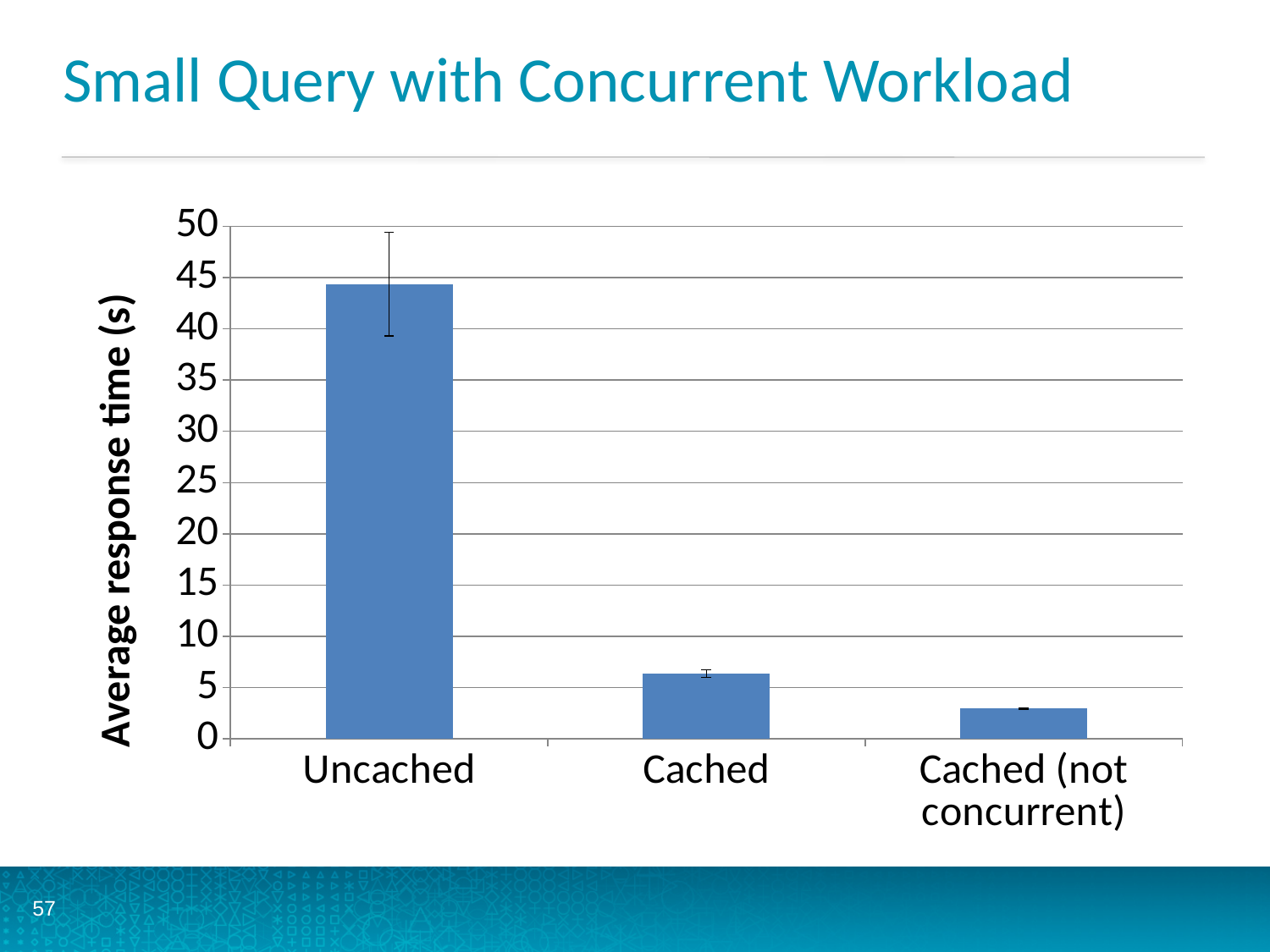
Is the value for Uncached greater or less than 40? greater What is the title of the slide containing the chart? Small Query with Concurrent Workload Which category has the lowest average response time? Cached (not concurrent) What kind of chart is shown on the slide? bar chart How many categories are shown on the x axis? 3 Is the value for Cached greater or less than 10? less Which has a larger average response time, Uncached or Cached? Uncached Which category has the highest average response time? Uncached Do the bar values rise or fall from left to right across the x axis? fall What is the label of the y axis? Average response time (s) Which has a larger average response time, Cached or Cached (not concurrent)? Cached Is the value for Cached (not concurrent) greater or less than 5? less